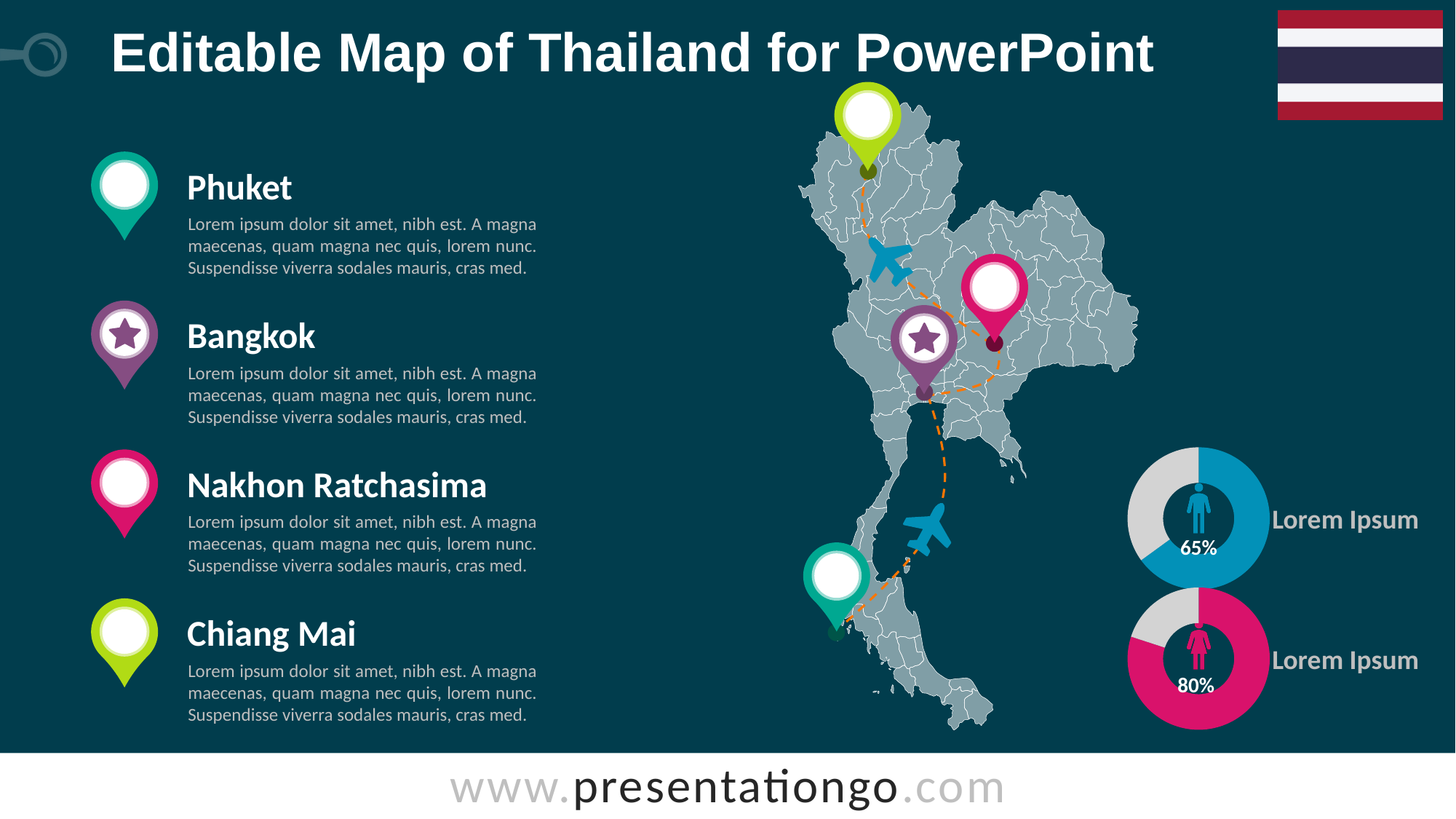
Which of the two donut charts on the right shows the larger percentage, the upper one or the lower one? the lower one (80%) What percentage is shown in the lower donut chart on the right of the slide? 80% What kind of chart is used to display the 65% and 80% values on the right of the slide? donut chart How many donut charts are on the slide? 2 What text label appears to the right of each donut chart? Lorem Ipsum What percentage is shown in the upper donut chart on the right of the slide? 65% Is the value shown in the lower donut chart greater or less than 75%? greater Is the value shown in the upper donut chart greater or less than 50%? greater What is the difference between the percentages shown in the lower and upper donut charts? 15% What share of the upper donut chart is not filled by the 65% segment? 35% What colour is the filled segment of the upper donut chart? blue